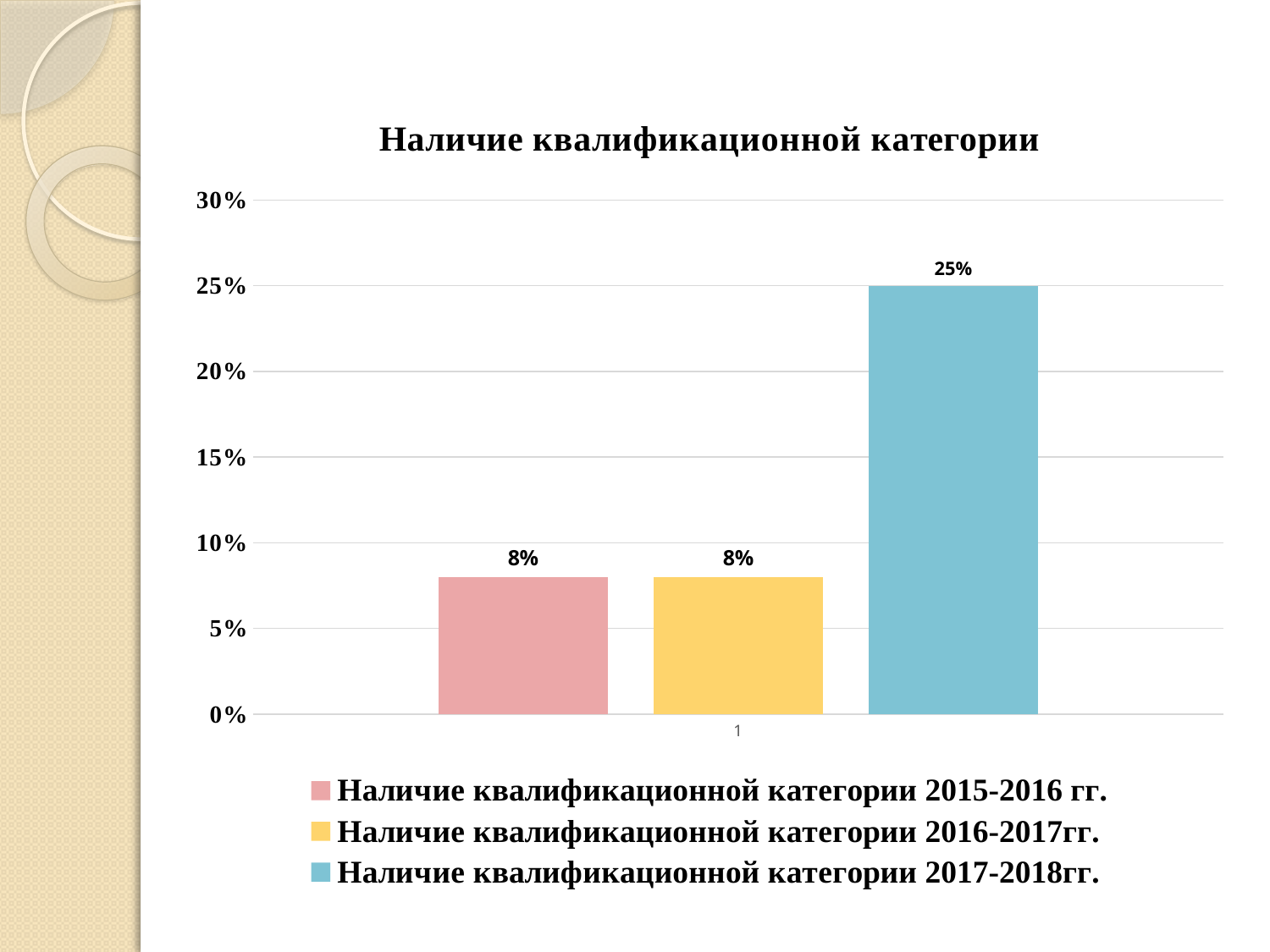
What kind of chart is shown on the slide? bar chart How many bars are plotted on the chart? 3 How many series does the legend list? 3 What is the difference between the value for 2017-2018гг. and the value for 2016-2017гг.? 17% Which series has the highest value? Наличие квалификационной категории 2017-2018гг. What is the value for Наличие квалификационной категории 2016-2017гг.? 8% Is the value for Наличие квалификационной категории 2015-2016 гг. greater or less than 10%? less What is the title of the chart? Наличие квалификационной категории What is the value for Наличие квалификационной категории 2017-2018гг.? 25% Which is larger: the value for 2017-2018гг. or the value for 2015-2016 гг.? 2017-2018гг. What is the value for Наличие квалификационной категории 2015-2016 гг.? 8% Is the value for Наличие квалификационной категории 2017-2018гг. greater or less than 20%? greater